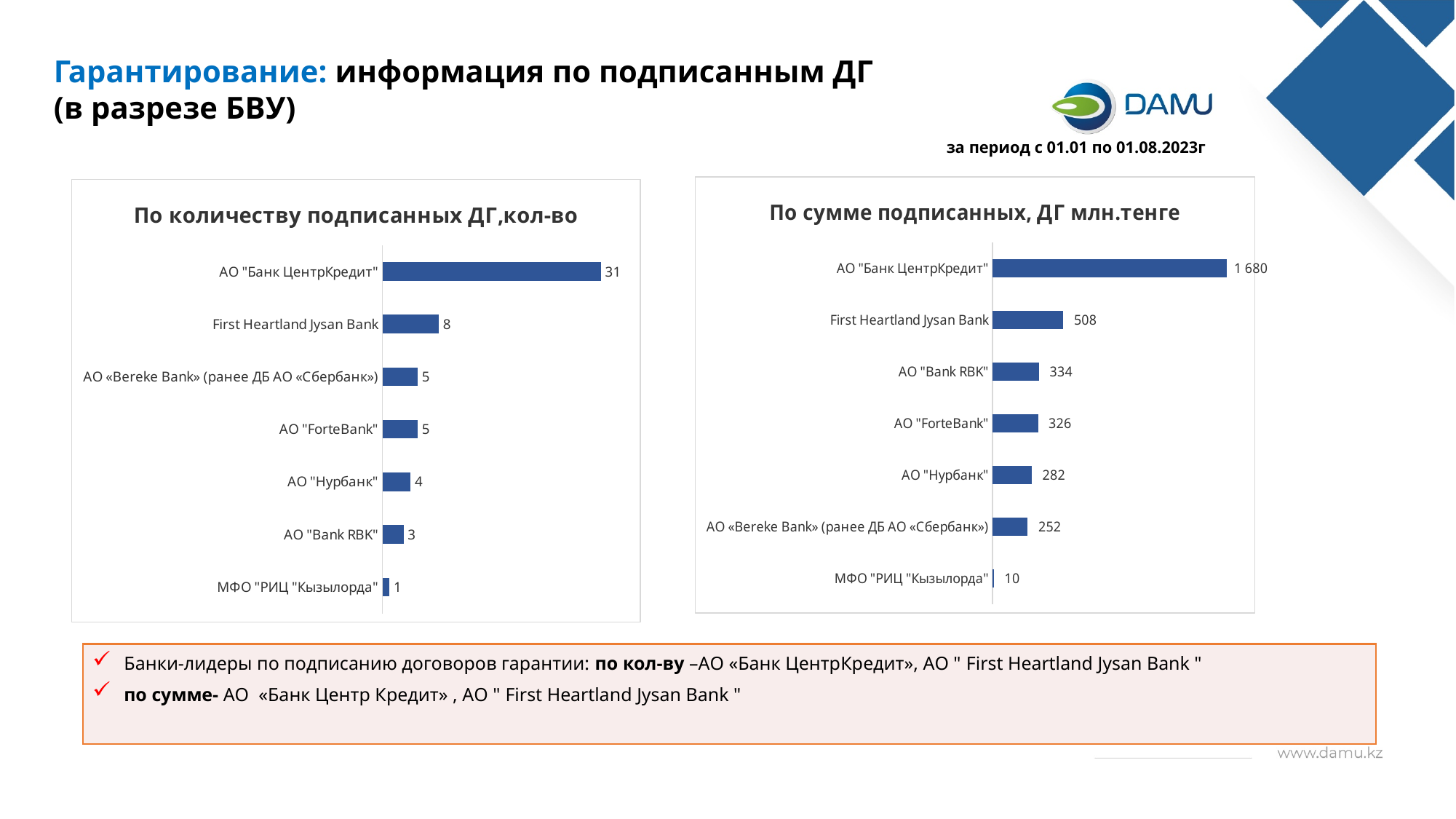
What type of chart is 'По сумме подписанных, ДГ млн.тенге'? Bar chart What is the title of the chart on the left side of the slide? По количеству подписанных ДГ,кол-во In the chart 'По сумме подписанных, ДГ млн.тенге', what is the value for First Heartland Jysan Bank? 508 In the chart 'По сумме подписанных, ДГ млн.тенге', what is the value for АО "Нурбанк"? 282 In the chart 'По сумме подписанных, ДГ млн.тенге', what is the difference between АО "Bank RBK" and АО "ForteBank"? 8 In the chart 'По количеству подписанных ДГ,кол-во', what is the value for АО "Bank RBK"? 3 In the chart 'По количеству подписанных ДГ,кол-во', what is the value for АО "Банк ЦентрКредит"? 31 In the chart 'По количеству подписанных ДГ,кол-во', which category has the lowest value? МФО "РИЦ "Кызылорда" How many categories are shown in the chart 'По количеству подписанных ДГ,кол-во'? 7 In the chart 'По количеству подписанных ДГ,кол-во', what is the difference between АО "Банк ЦентрКредит" and First Heartland Jysan Bank? 23 In the chart 'По сумме подписанных, ДГ млн.тенге', which category has the highest value? АО "Банк ЦентрКредит" In the chart 'По сумме подписанных, ДГ млн.тенге', which is larger: АО «Bereke Bank» (ранее ДБ АО «Сбербанк») or АО "Нурбанк"? АО "Нурбанк"